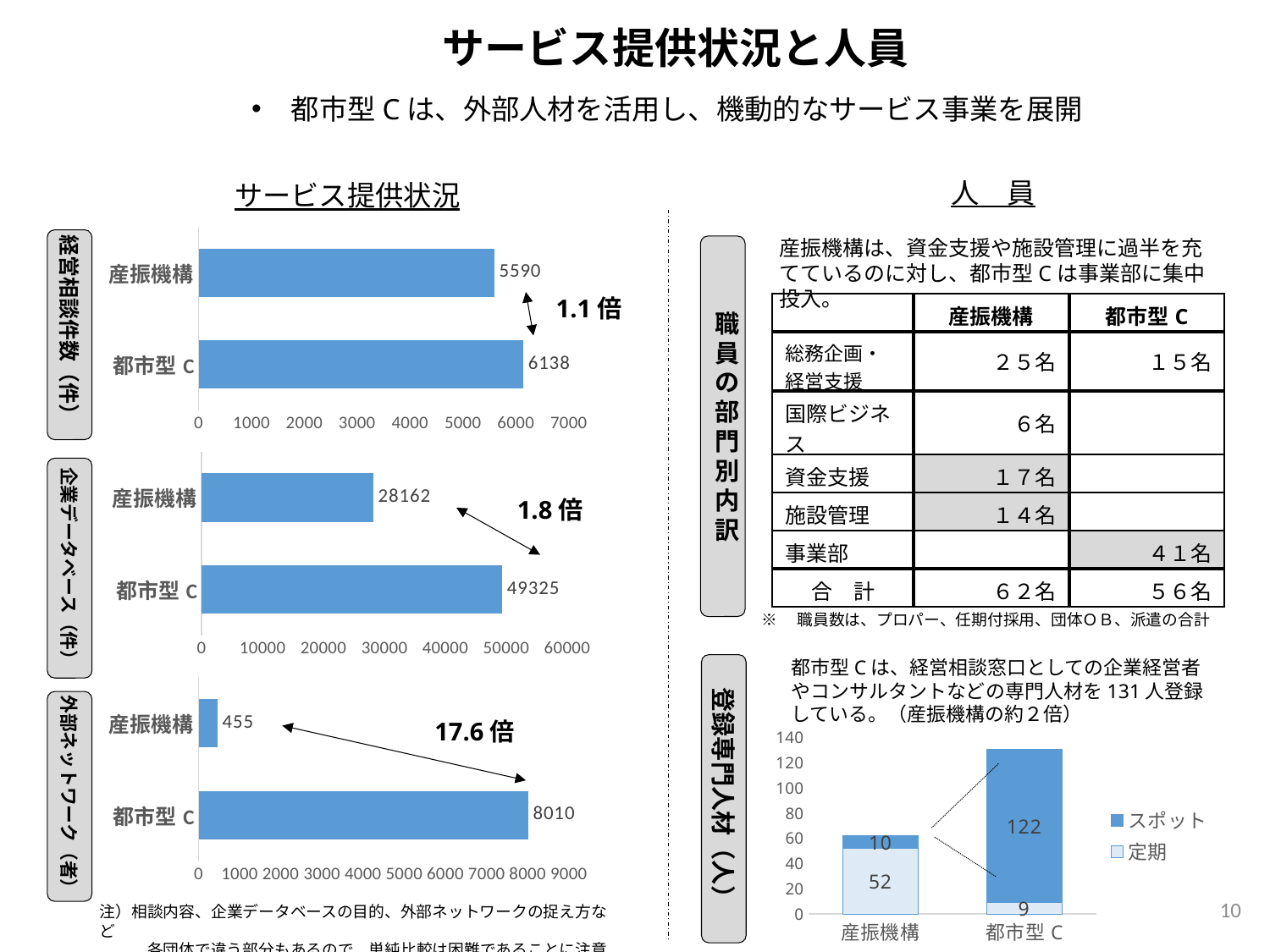
In the 企業データベース chart, what is the value for 都市型C? 49325 In the 外部ネットワーク chart, what is the value for 産振機構? 455 In the 登録専門人材 chart, what is the total of the stacked bar for 産振機構? 62 In the 経営相談件数 chart, what is the difference between 都市型C and 産振機構? 548 In the 企業データベース chart, which category has the higher value, 産振機構 or 都市型C? 都市型C What type of chart is the 外部ネットワーク chart? bar chart How many series does the legend of the 登録専門人材 chart list? 2 In the 登録専門人材 chart, what is the 定期 value for 都市型C? 9 In the 外部ネットワーク chart, what is the difference between 都市型C and 産振機構? 7555 In the 経営相談件数 chart, what is the value for 都市型C? 6138 In the 経営相談件数 chart, what is the value for 産振機構? 5590 In the 登録専門人材 chart, what is the スポット value for 都市型C? 122